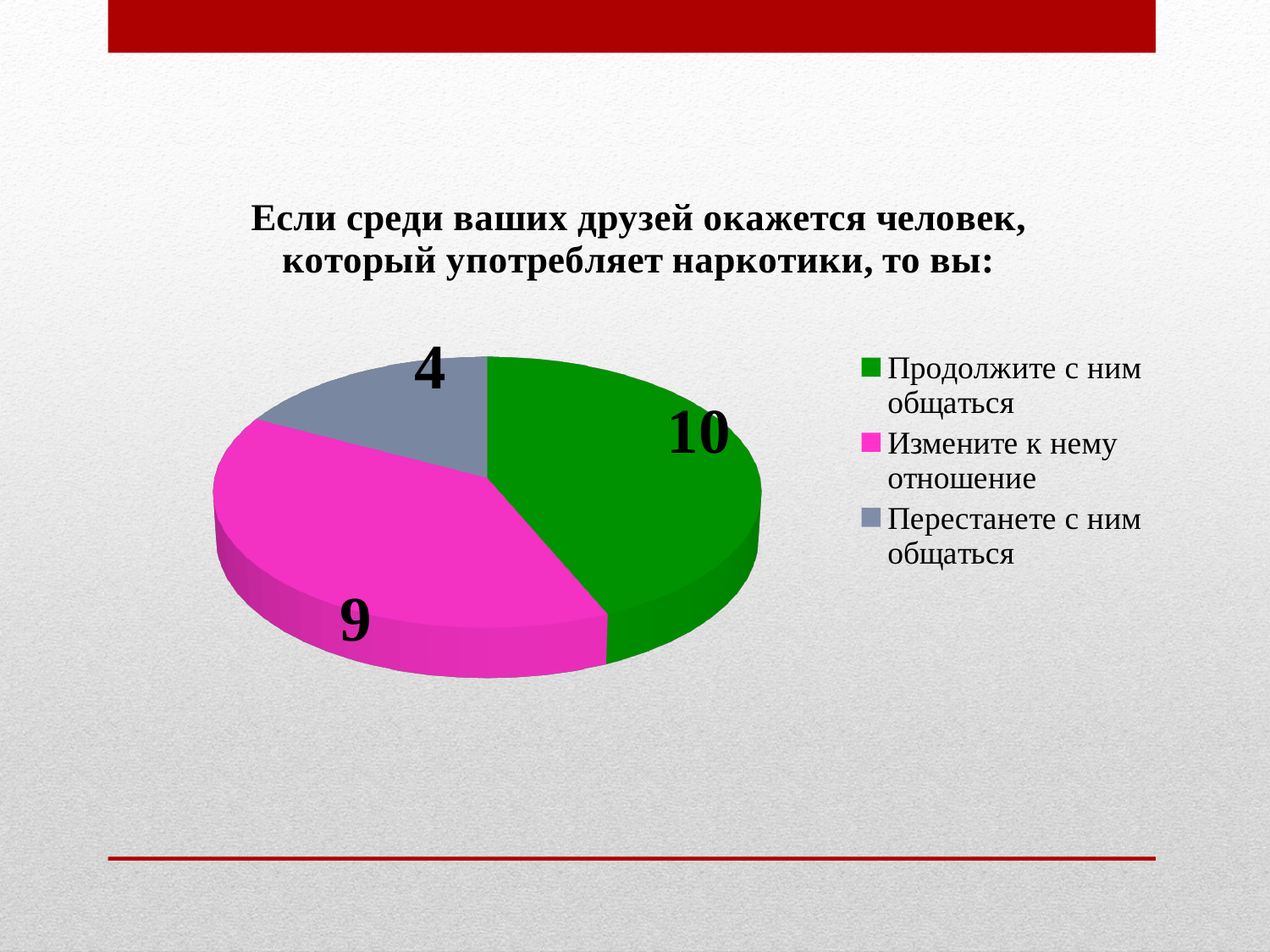
How many categories does the pie chart have? 3 What colour is the slice for "Измените к нему отношение"? pink What is the value for "Измените к нему отношение"? 9 What is the total of all the values shown in the pie chart? 23 Which is larger: the value for "Измените к нему отношение" or the value for "Перестанете с ним общаться"? Измените к нему отношение What is the value for "Перестанете с ним общаться"? 4 What is the difference between the values for "Продолжите с ним общаться" and "Перестанете с ним общаться"? 6 Which category has the largest slice of the pie? Продолжите с ним общаться What kind of chart is shown on the slide? pie chart What is the value for "Продолжите с ним общаться"? 10 What is the difference between the values for "Измените к нему отношение" and "Перестанете с ним общаться"? 5 Which category has the smallest slice of the pie? Перестанете с ним общаться